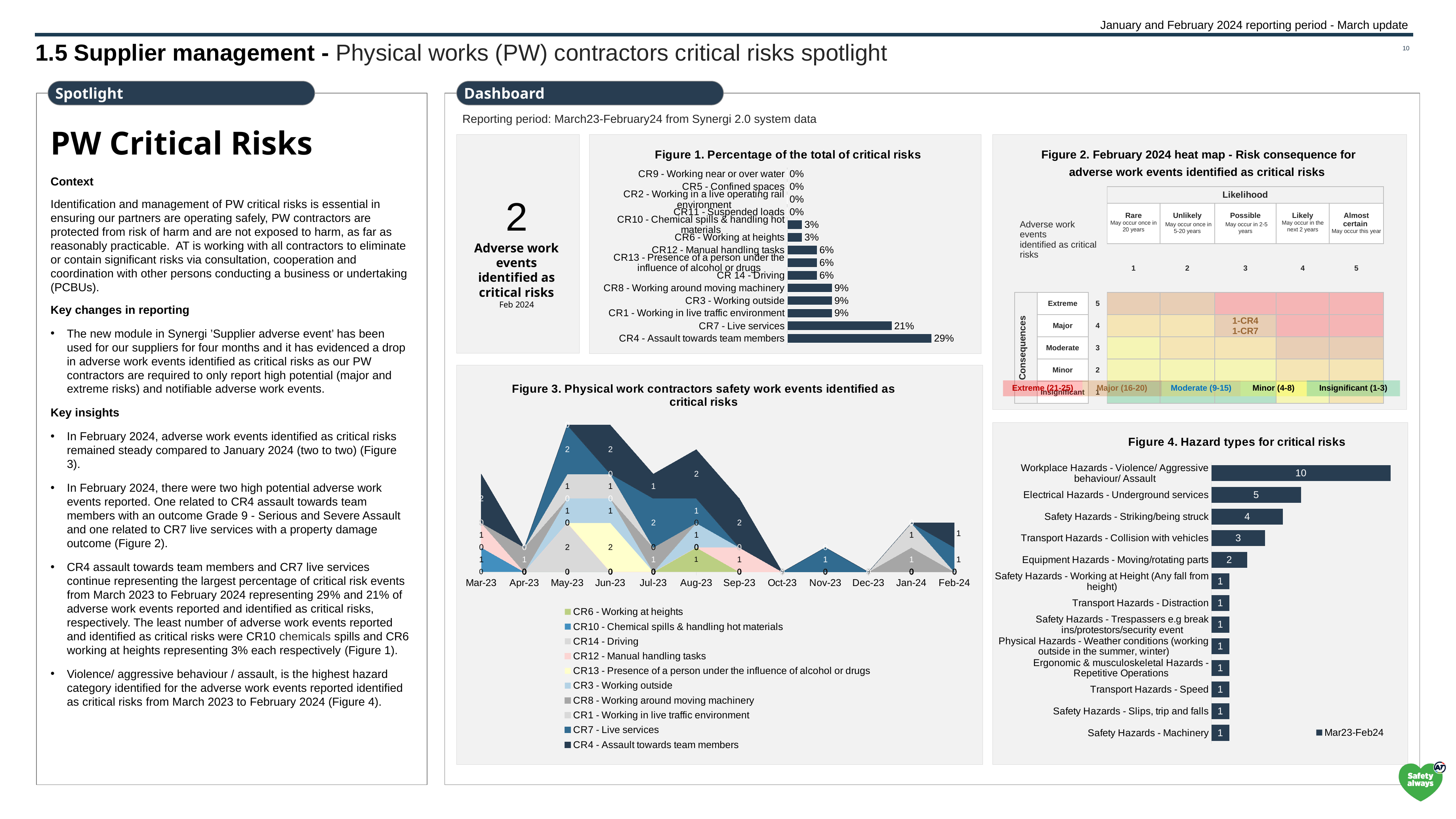
In Figure 1, which is larger: CR8 - Working around moving machinery or CR6 - Working at heights? CR8 - Working around moving machinery In Figure 4, what is the value for Electrical Hazards - Underground services? 5 What is the title of Figure 3? Physical work contractors safety work events identified as critical risks In Figure 1, what percentage of the total of critical risks is CR4 - Assault towards team members? 29% In Figure 4, what is the difference between Workplace Hazards - Violence/ Aggressive behaviour/ Assault and Safety Hazards - Striking/being struck? 6 In Figure 4, what is the value for Workplace Hazards - Violence/ Aggressive behaviour/ Assault? 10 How many categories are plotted in Figure 1? 14 In Figure 1, what percentage is shown for CR7 - Live services? 21% What kind of chart is Figure 4? Bar chart How many series does the legend of Figure 3 list? 10 In Figure 1, which category has the highest percentage? CR4 - Assault towards team members In Figure 1, what is the difference in percentage points between CR4 - Assault towards team members and CR7 - Live services? 8